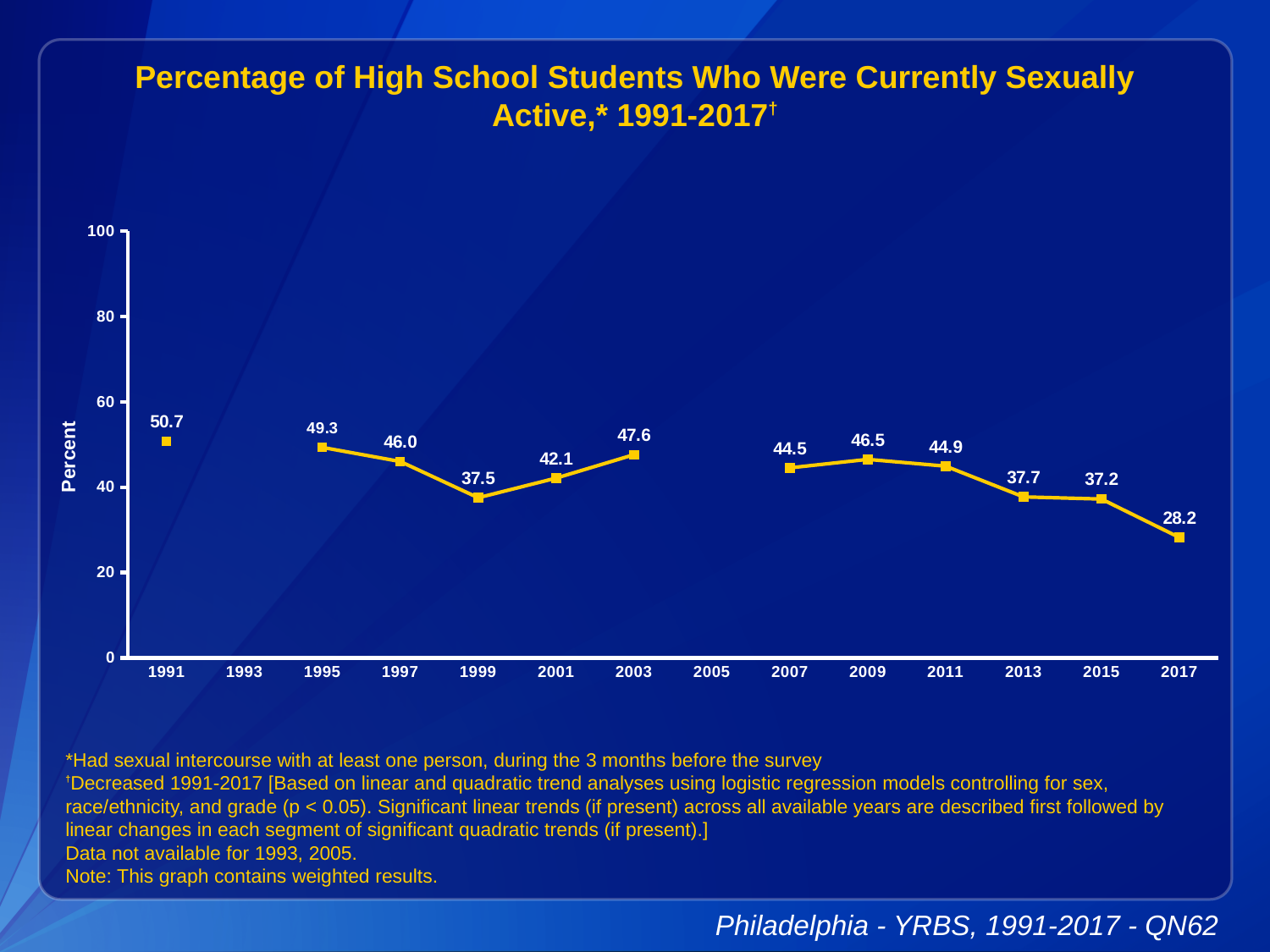
What was the percentage of high school students who were currently sexually active in 1991? 50.7 Do the plotted values generally rise or fall from 2011 to 2017? fall What kind of chart is shown on the slide? line chart How many data points are plotted on the chart? 12 What is the label on the y axis of the chart? Percent Which year has the larger value, 2003 or 2007? 2003 Is the value for 2013 greater or less than 40? less Which year has the highest plotted value? 1991 Which year has the lowest plotted value? 2017 What value is plotted for 2009? 46.5 What value is plotted for 2017? 28.2 What is the difference between the values for 1991 and 2017? 22.5